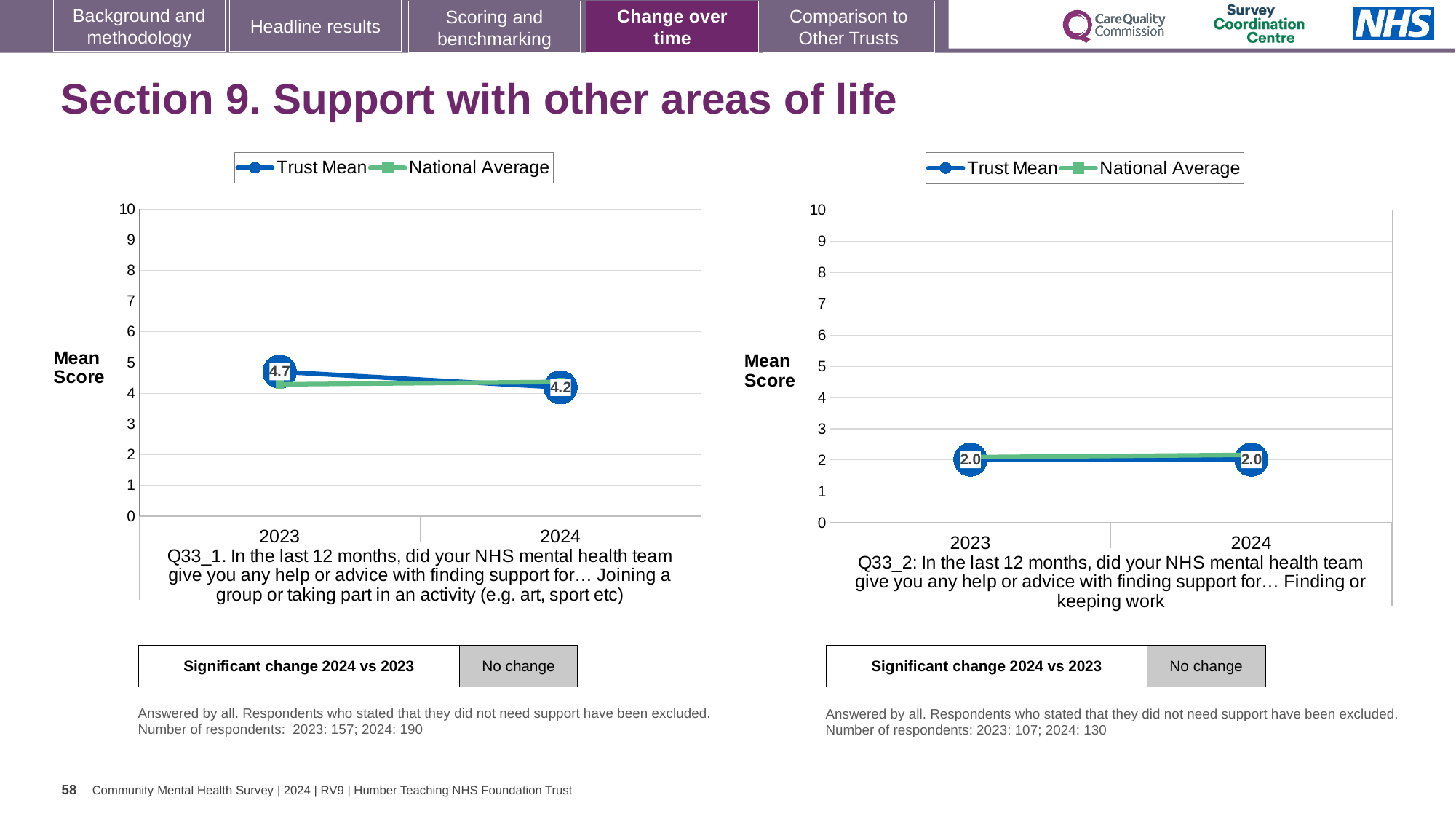
In the right chart (Q33_2), what is the Trust Mean for 2024? 2.0 In the right chart (Q33_2), does the Trust Mean rise, fall or stay the same from 2023 to 2024? stay the same In the right chart (Q33_2), is the National Average for 2024 greater or less than 3? less How many series does the legend of the right chart (Q33_2) list? 2 In the left chart (Q33_1), is the National Average for 2023 greater or less than 5? less In the left chart (Q33_1), does the Trust Mean rise or fall from 2023 to 2024? fall In the left chart (Q33_1), what is the difference between the Trust Mean in 2023 and in 2024? 0.5 In the left chart (Q33_1), what is the Trust Mean for 2024? 4.2 What kind of chart is the left chart (Q33_1)? line chart How many years are shown on the x axis of the left chart (Q33_1)? 2 In the left chart (Q33_1), which year has the higher Trust Mean, 2023 or 2024? 2023 In the left chart (Q33_1), what is the Trust Mean for 2023? 4.7